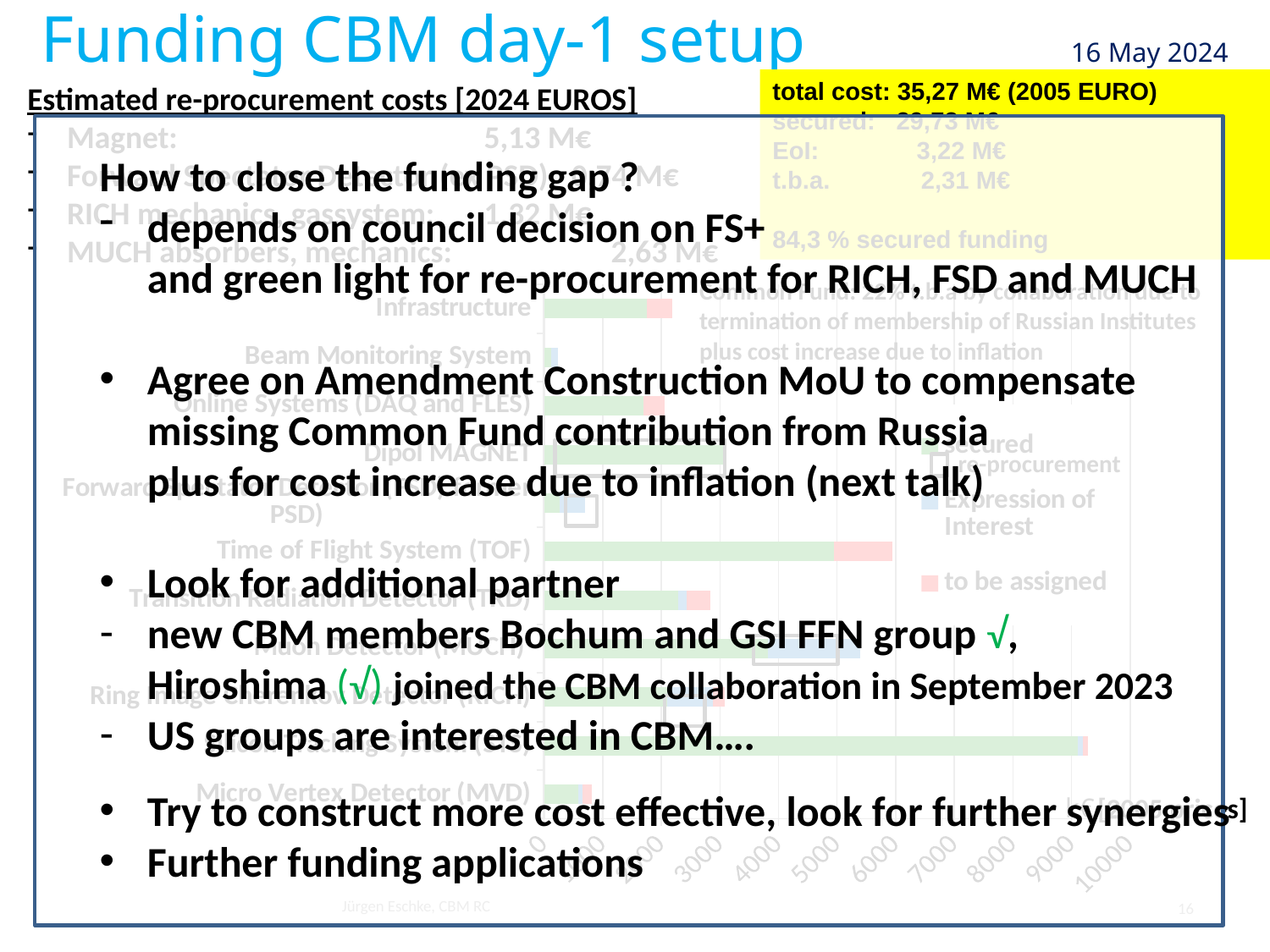
Which category has the shortest bar on the chart? Beam Monitoring System How many detector/system categories are plotted on the chart? 11 Which has the longer bar, Time of Flight System (TOF) or Micro Vertex Detector (MVD)? Time of Flight System (TOF) What is the highest tick value shown on the chart's x axis? 10000 How many series does the chart legend list? 4 Which has the longer bar, Silicon Tracking System (STS) or Time of Flight System (TOF)? Silicon Tracking System (STS) Is the total bar for Micro Vertex Detector (MVD) greater or less than 2000? less Is the total bar for Silicon Tracking System (STS) greater or less than 5000? greater What kind of chart is shown on the slide? bar chart Is the total bar for Beam Monitoring System greater or less than 1000? less Which category has the longest bar on the chart? Silicon Tracking System (STS)